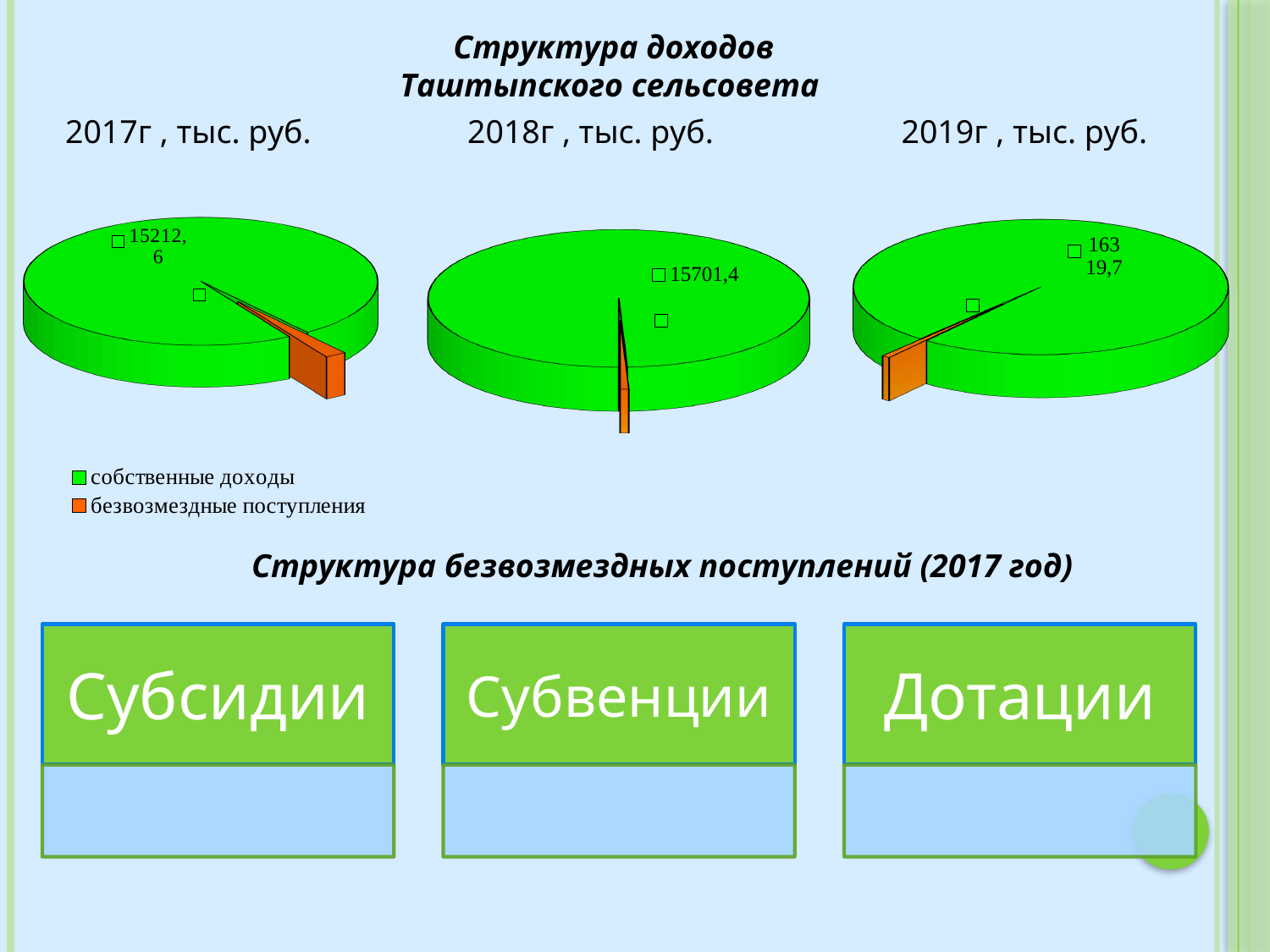
How many entries does the legend list for the pie charts? 2 In the 2017г pie chart, which category takes the smallest share? безвозмездные поступления In the 2018г pie chart, which category takes the largest share? собственные доходы In the 2017г pie chart, what is the value labelled for собственные доходы? 15212,6 In the 2018г pie chart, what is the value labelled for собственные доходы? 15701,4 In the 2019г pie chart, what is the value labelled for собственные доходы? 16319,7 Do the labelled собственные доходы values rise or fall from the 2017г chart to the 2019г chart? Rise Which is larger: собственные доходы in the 2017г chart or in the 2019г chart? 2019г What is the difference between собственные доходы in the 2019г chart and in the 2017г chart? 1107,1 Which colour represents безвозмездные поступления in the pie charts? Orange What kind of chart is used for the 2017г, 2018г and 2019г income structure? Pie chart What unit is stated above each pie chart? тыс. руб.